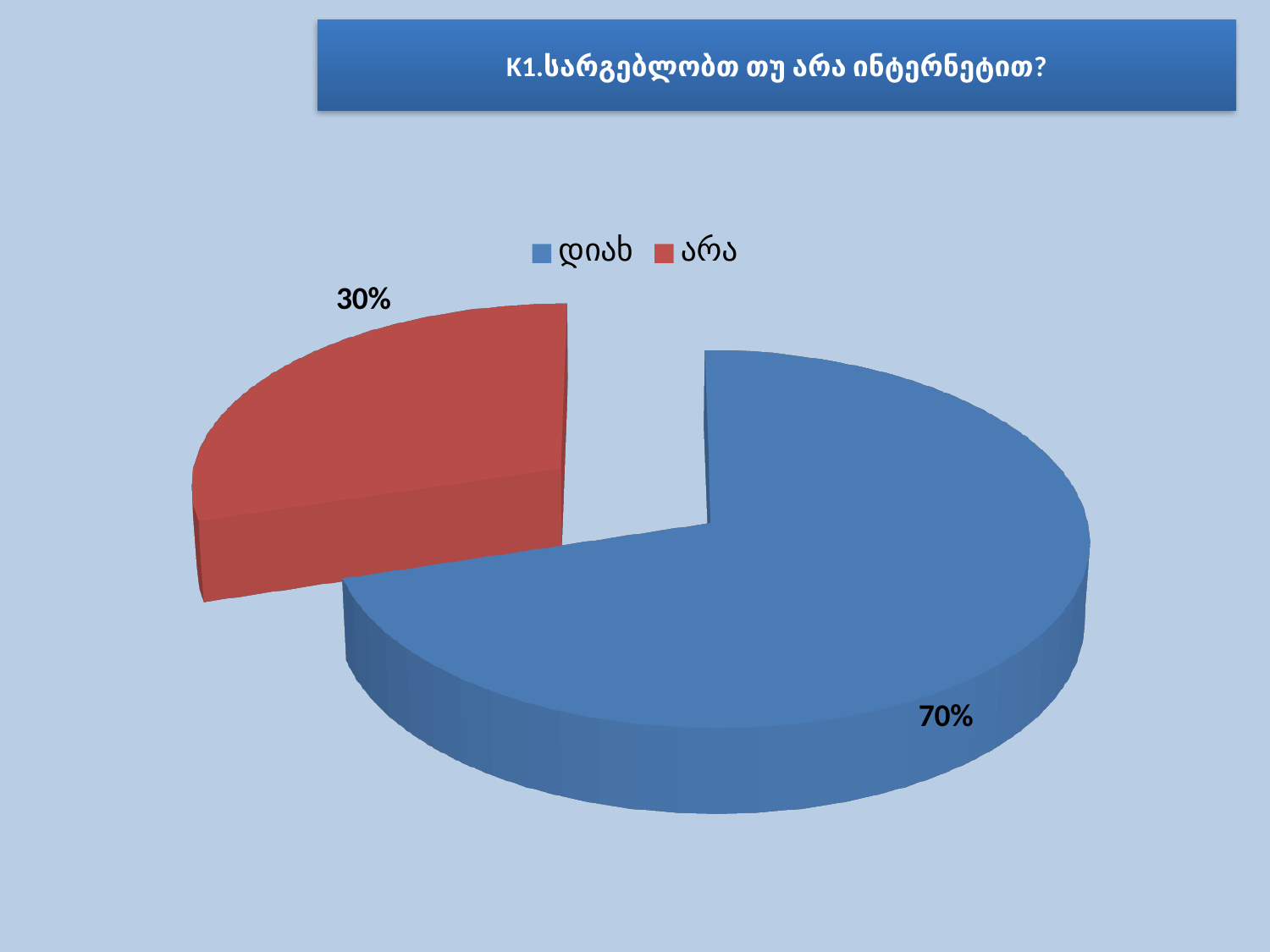
What percentage of the pie is the "არა" slice? 30% Which category has the largest share of the pie? დიახ What percentage of the pie is the "დიახ" slice? 70% Which category has the smallest share of the pie? არა What is the share of the pie taken by the "არა" slice? 30% What kind of chart is shown on the slide? Pie chart What is the difference in percentage points between the "დიახ" and "არა" slices? 40 How many entries does the legend list? 2 How many slices does the pie chart have? 2 Which slice is larger, "დიახ" or "არა"? დიახ What is the title shown above the chart? K1.სარგებლობთ თუ არა ინტერნეტით? What colour is the "არა" slice? Red